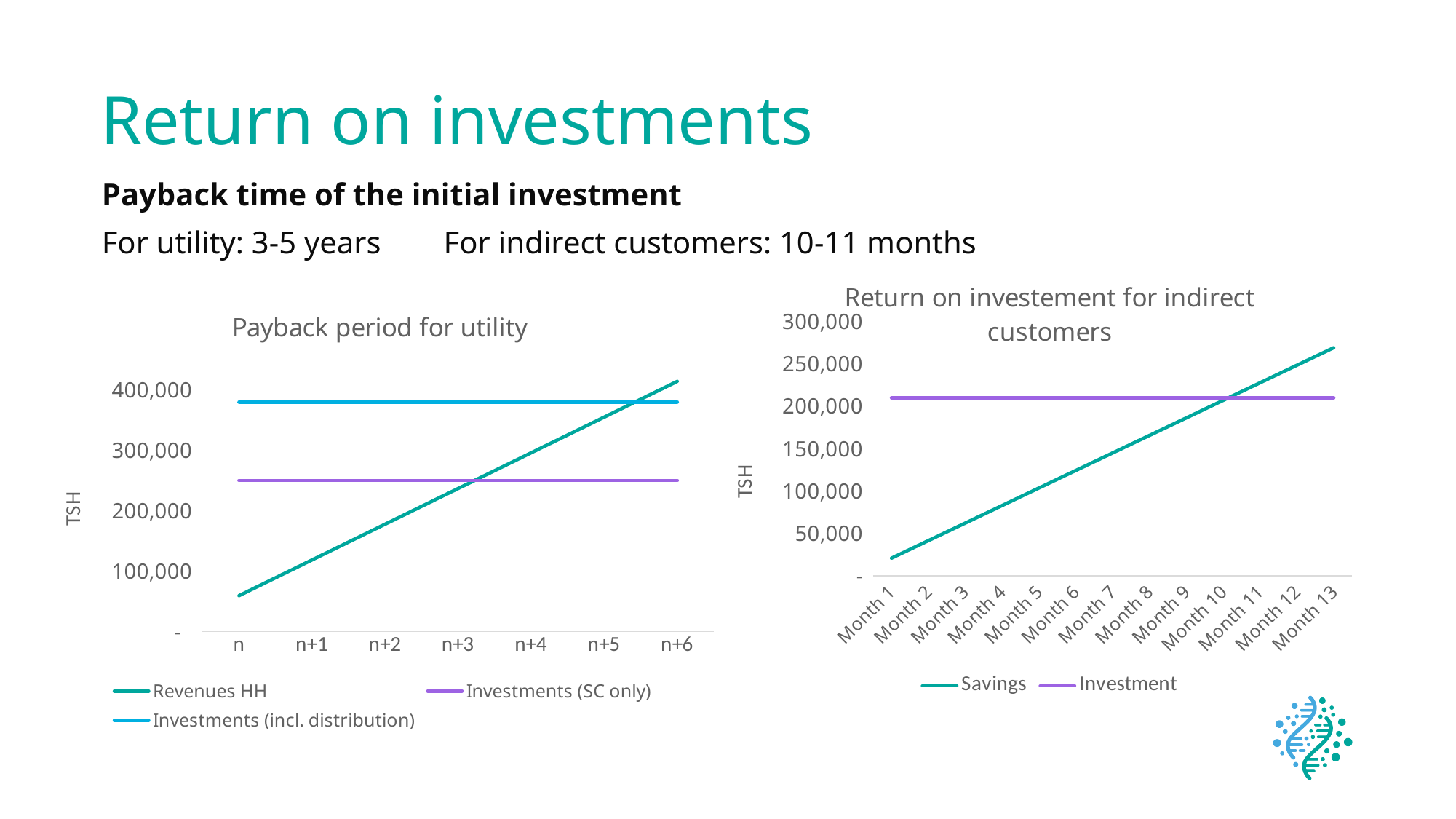
What is the label of the y axis on the 'Payback period for utility' chart? TSH How many series does the legend of the 'Payback period for utility' chart list? 3 How many months are shown on the x axis of the 'Return on investement for indirect customers' chart? 13 In the 'Payback period for utility' chart, does the Revenues HH line rise or fall from n to n+6? rise In the 'Return on investement for indirect customers' chart, is the value of Savings at Month 1 greater or less than 50,000? less What kind of chart is the 'Payback period for utility' chart? line chart How many series does the legend of the 'Return on investement for indirect customers' chart list? 2 In the 'Payback period for utility' chart, at n+6, which is larger: Revenues HH or Investments (incl. distribution)? Revenues HH How many categories are on the x axis of the 'Payback period for utility' chart? 7 In the 'Payback period for utility' chart, is the value of Investments (incl. distribution) greater or less than 300,000? greater In the 'Return on investement for indirect customers' chart, at Month 13, which is larger: Savings or Investment? Savings In the 'Payback period for utility' chart, is the value of Revenues HH at n greater or less than 100,000? less